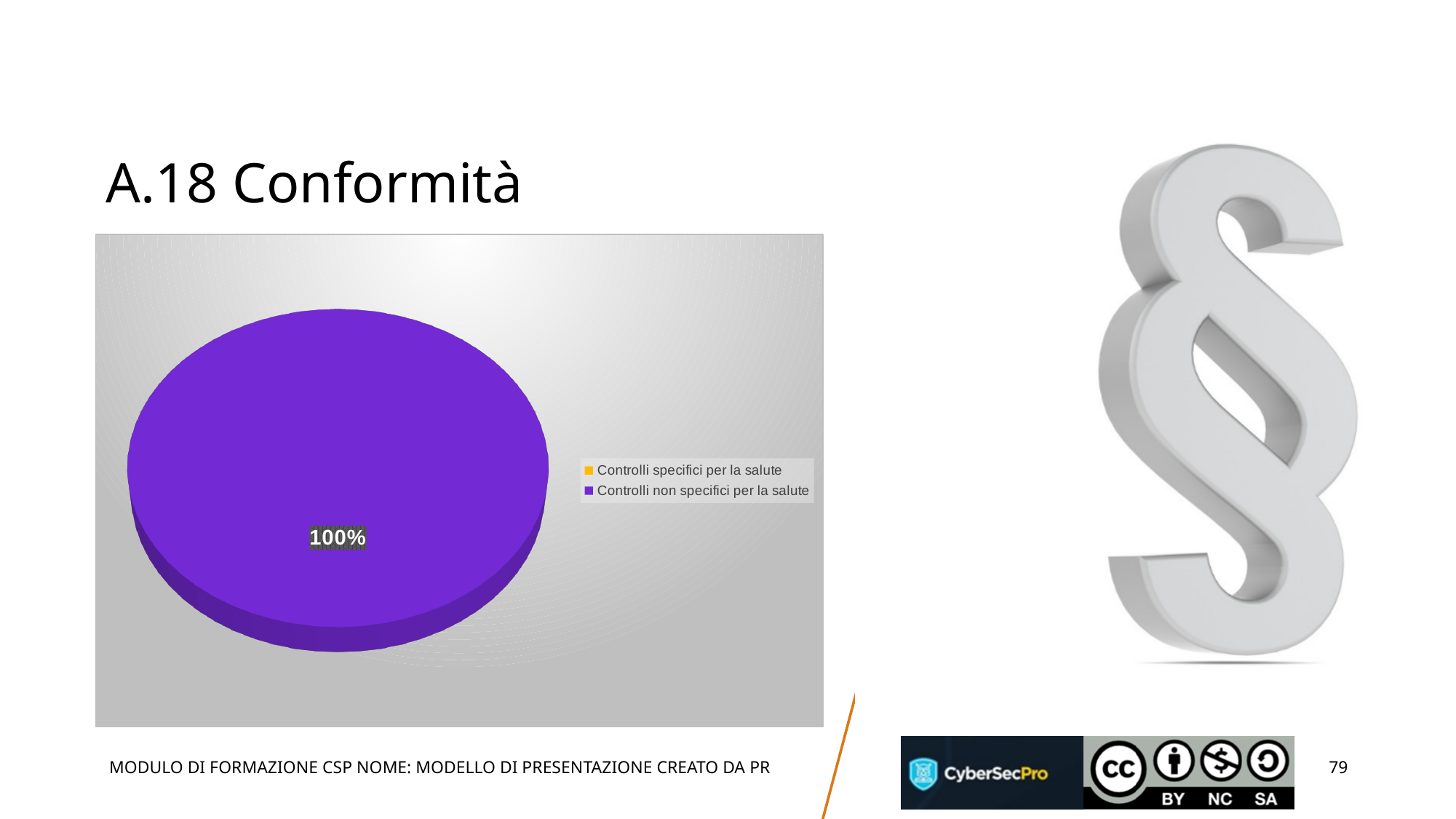
Which is larger: the share for "Controlli specifici per la salute" or for "Controlli non specifici per la salute"? Controlli non specifici per la salute What kind of chart is shown on the slide? pie chart Is the share for "Controlli non specifici per la salute" greater or less than 50%? greater What colour does the legend assign to "Controlli specifici per la salute"? yellow What share of the pie does "Controlli non specifici per la salute" take? 100% Which legend entry has the smaller share of the pie? Controlli specifici per la salute How many entries does the chart's legend list? 2 What percentage label is printed on the pie? 100% What colour is the slice for "Controlli non specifici per la salute"? purple Which legend entry accounts for the whole pie? Controlli non specifici per la salute